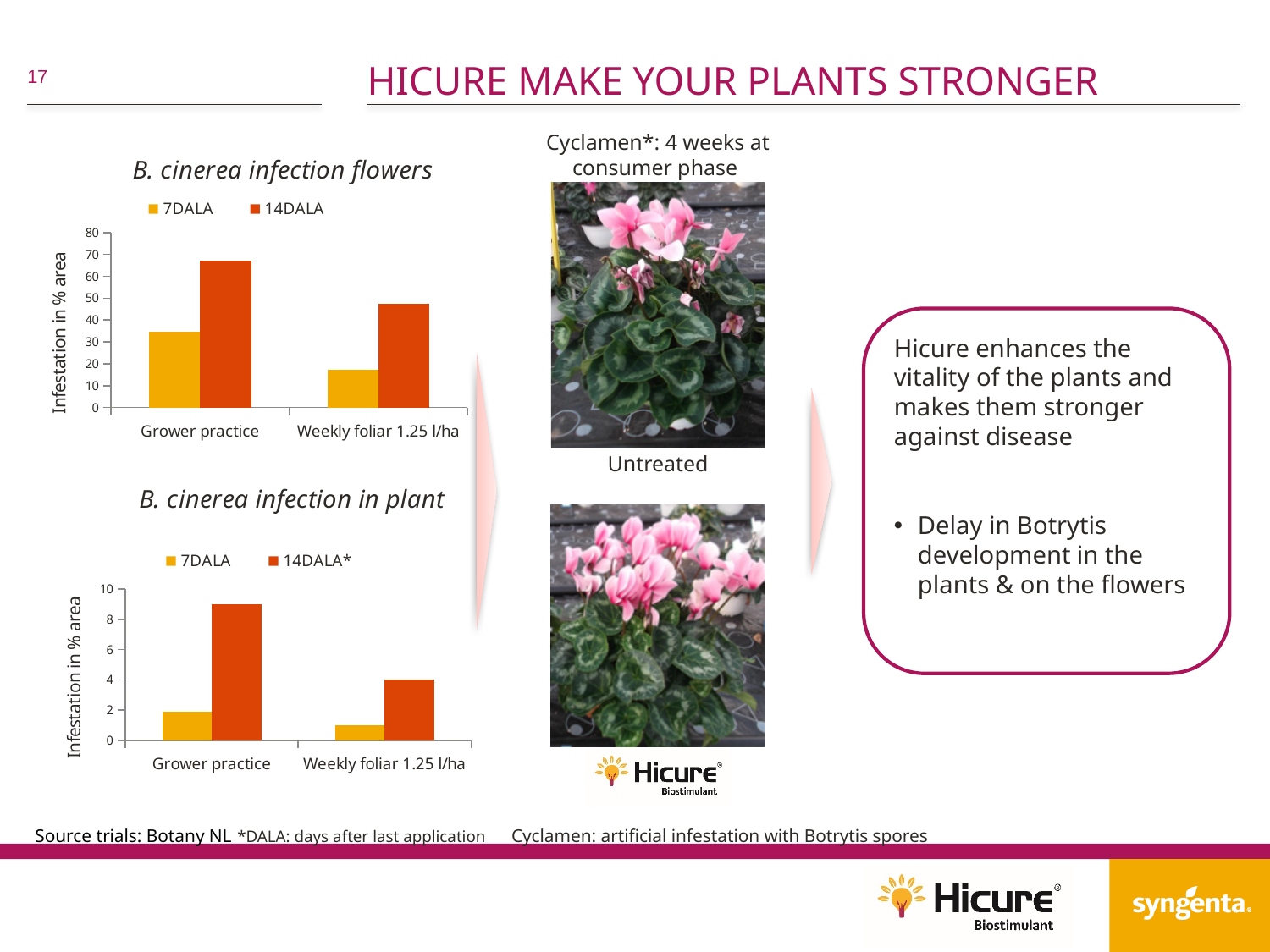
In the 'B. cinerea infection in plant' chart, what is the label of the y axis? Infestation in % area In the 'B. cinerea infection flowers' chart, is the 14DALA value for Grower practice greater or less than 60? greater In the 'B. cinerea infection flowers' chart, how many categories are shown on the x axis? 2 In the 'B. cinerea infection in plant' chart, which category has the lowest 7DALA value? Weekly foliar 1.25 l/ha In the 'B. cinerea infection flowers' chart, what kind of chart is shown? bar chart In the 'B. cinerea infection in plant' chart, is the 14DALA* value for Grower practice greater or less than 8? greater In the 'B. cinerea infection in plant' chart, is the 7DALA value for Weekly foliar 1.25 l/ha greater or less than 2? less In the 'B. cinerea infection flowers' chart, which is larger for Weekly foliar 1.25 l/ha: the 7DALA value or the 14DALA value? 14DALA In the 'B. cinerea infection flowers' chart, how many series does the legend list? 2 In the 'B. cinerea infection in plant' chart, how many series does the legend list? 2 In the 'B. cinerea infection flowers' chart, which category has the highest 14DALA value? Grower practice